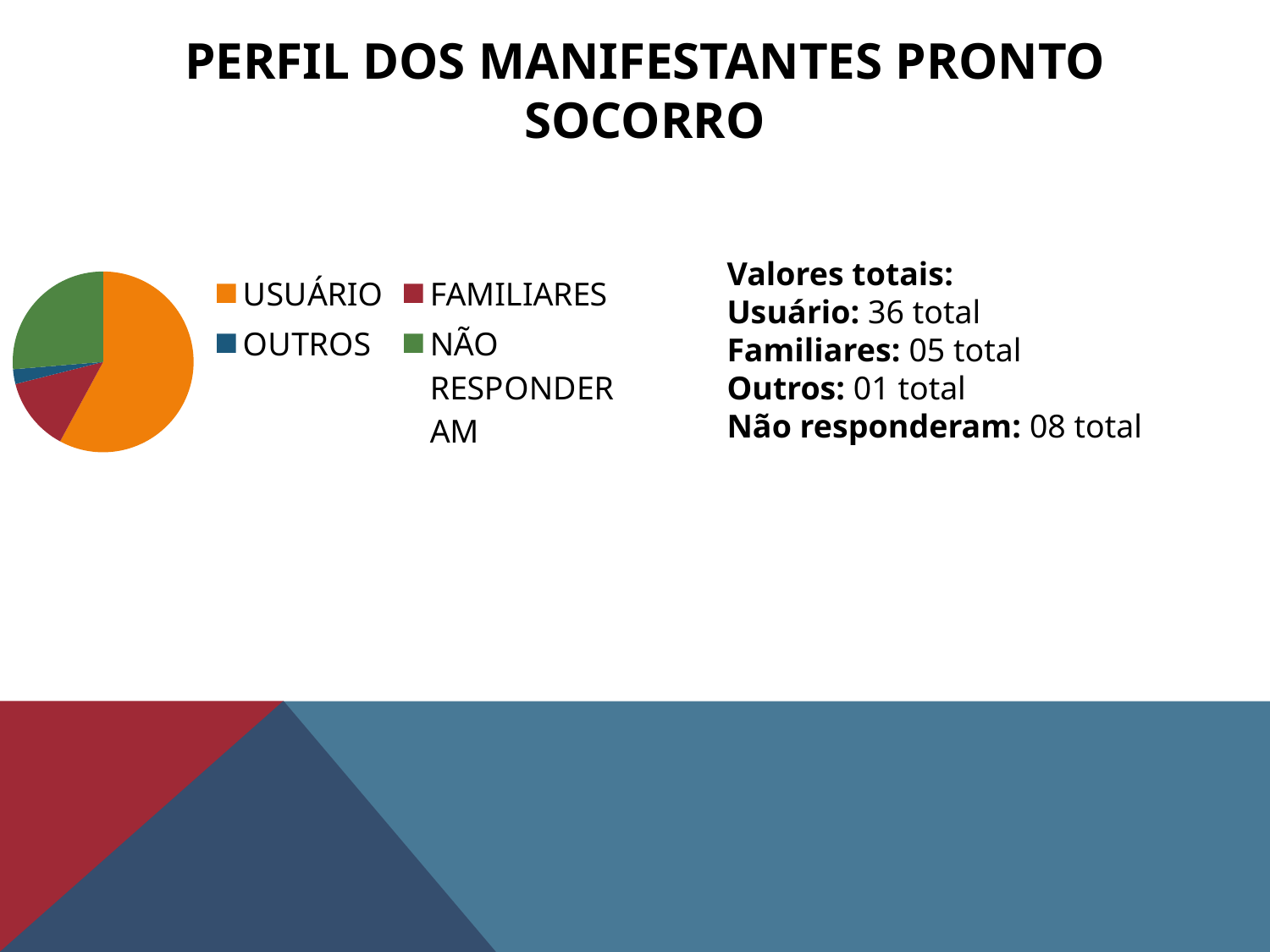
According to the slide, what is the total value for Usuário? 36 Which category has the largest slice of the pie chart? USUÁRIO What kind of chart is shown on the slide? pie chart How many categories does the pie chart's legend list? 4 What colour is the USUÁRIO slice in the pie chart? orange According to the slide, what is the total value for Familiares? 05 Which is larger, the slice for NÃO RESPONDERAM or the slice for FAMILIARES? NÃO RESPONDERAM Which category has the smallest slice of the pie chart? OUTROS What is the difference between the Usuário total and the Familiares total? 31 According to the slide, what is the total value for Não responderam? 08 What is the sum of all four totals listed on the slide? 50